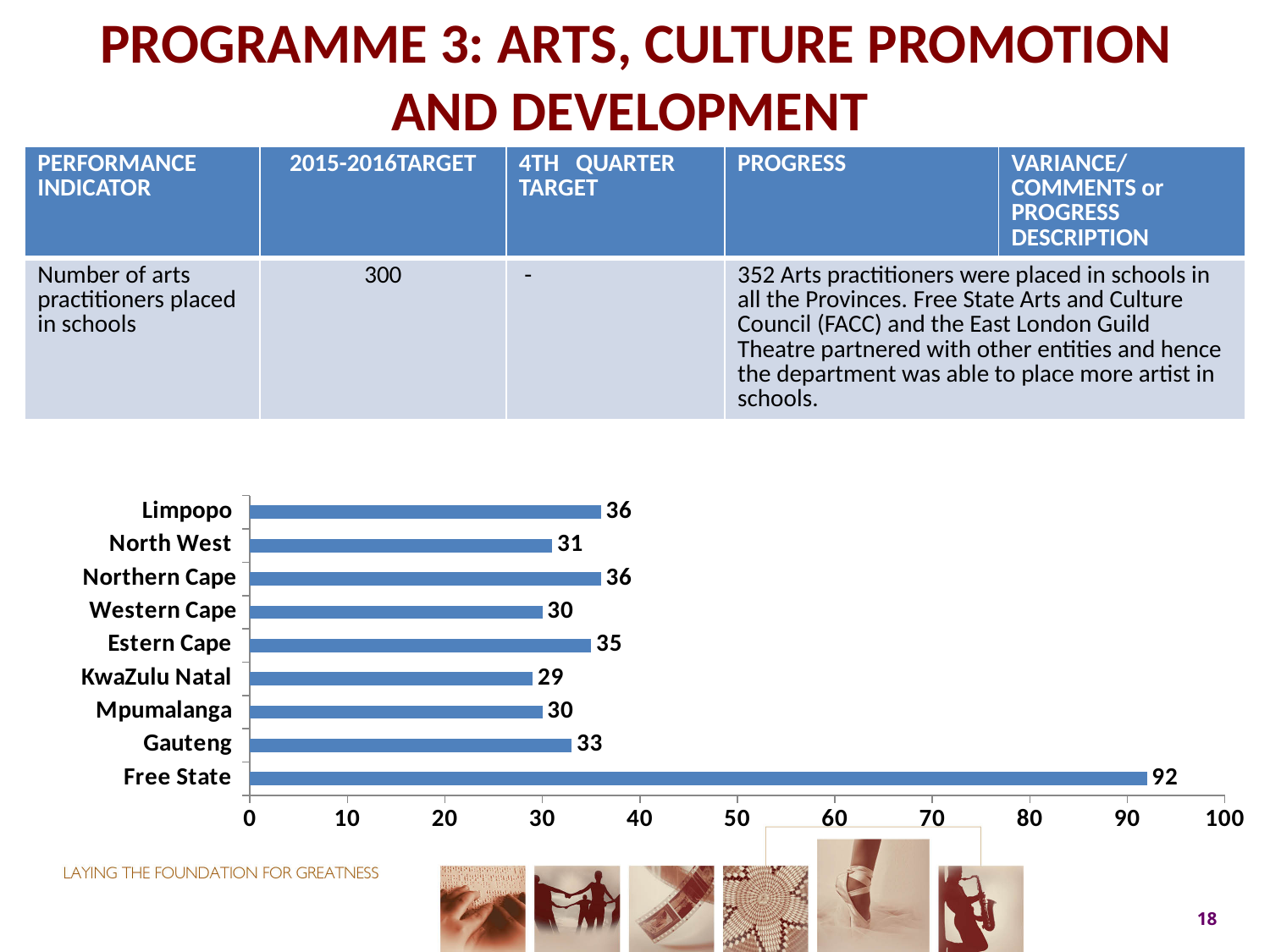
What is the value for Gauteng? 33 What is the difference between the values for Western Cape and Mpumalanga? 0 What is the value for Free State? 92 Which has a larger value, Estern Cape or North West? Estern Cape Is the value for Free State greater or less than 80? greater Which province has the highest value? Free State What kind of chart is shown on the slide? bar chart What is the value for KwaZulu Natal? 29 What is the difference between the values for Free State and Limpopo? 56 What is the maximum value shown on the horizontal axis of the chart? 100 Which province has the lowest value? KwaZulu Natal How many provinces are shown in the chart? 9